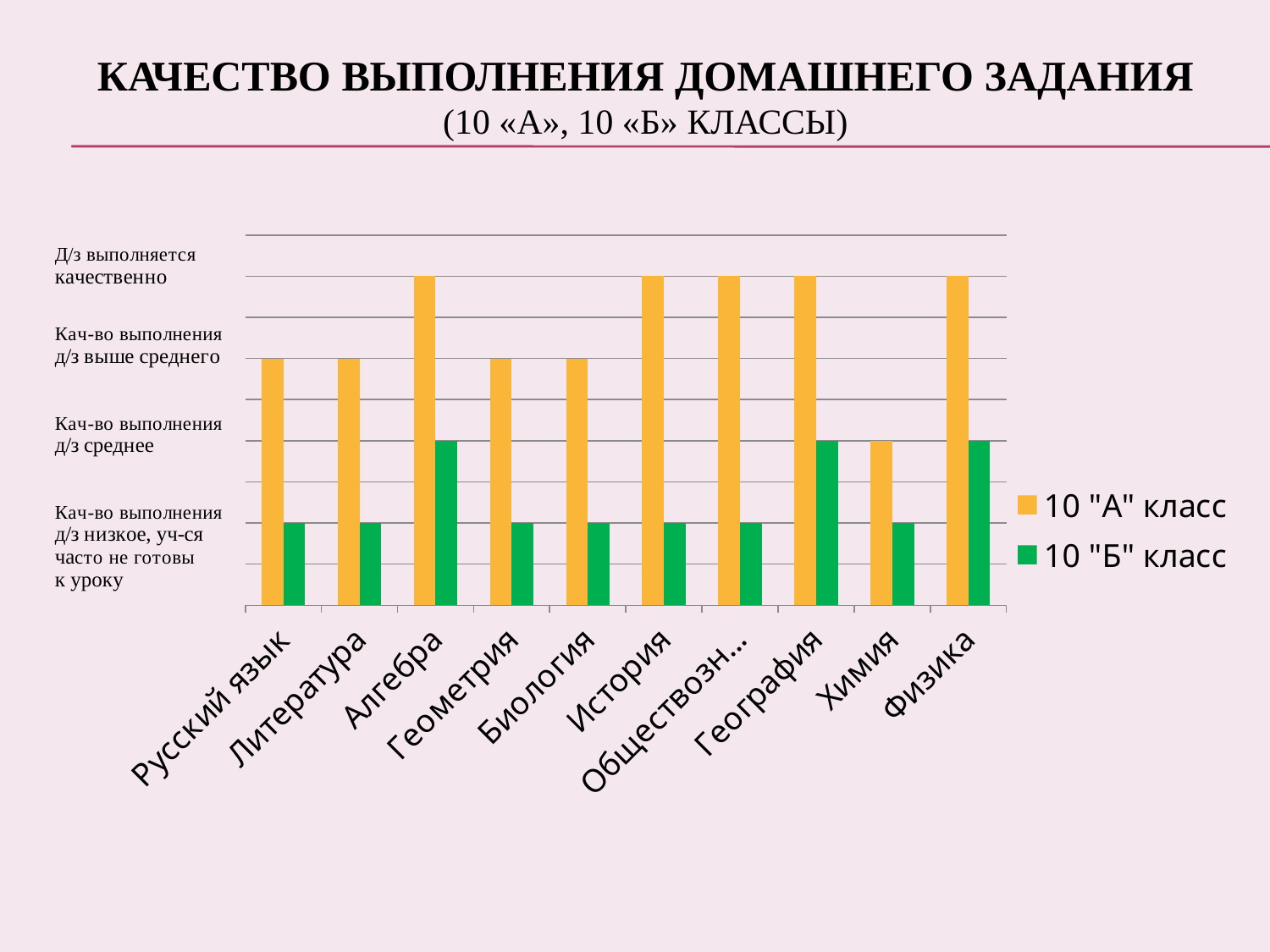
What level does the 10 "А" класс bar for Алгебра reach? Д/з выполняется качественно What is the title of the slide above the chart? КАЧЕСТВО ВЫПОЛНЕНИЯ ДОМАШНЕГО ЗАДАНИЯ (10 «А», 10 «Б» КЛАССЫ) For 10 "А" класс, which bar is higher, История or Геометрия? История How many series does the legend list? 2 Which colour represents 10 "Б" класс in the legend? green What level does the 10 "Б" класс bar for Русский язык reach? Кач-во выполнения д/з низкое, уч-ся часто не готовы к уроку For Алгебра, which class has the higher bar, 10 "А" класс or 10 "Б" класс? 10 "А" класс Which subject has the lowest bar for 10 "А" класс? Химия How many subjects (categories) are shown on the x axis? 10 What level does the 10 "Б" класс bar for Физика reach? Кач-во выполнения д/з среднее What level does the 10 "А" класс bar for Химия reach? Кач-во выполнения д/з среднее What kind of chart is shown on the slide? bar chart